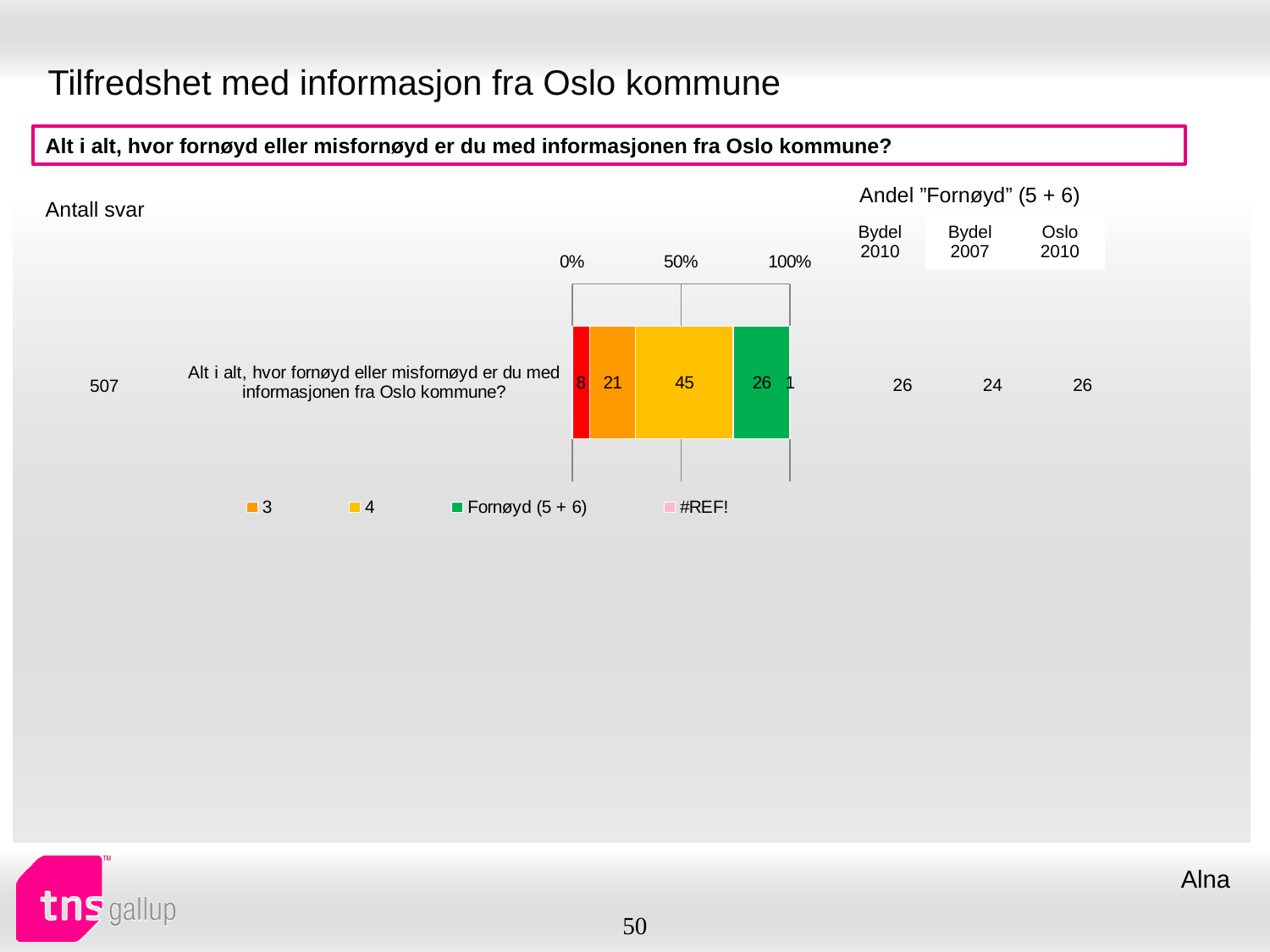
What is the "Antall svar" (number of responses) shown for the question? 507 What is the value of the "3" segment in the stacked bar? 21 Which legend category has the largest segment in the stacked bar? 4 What kind of chart is shown on the slide? bar chart What is the difference between the "4" segment and the "Fornøyd (5 + 6)" segment? 19 What is the value of the "Fornøyd (5 + 6)" segment in the stacked bar? 26 What is the value of the "4" segment in the stacked bar? 45 How many bars does the chart contain? 1 What is the value of the red segment at the left end of the stacked bar? 8 Which is larger, the "3" segment or the "Fornøyd (5 + 6)" segment? Fornøyd (5 + 6) How many entries does the chart legend list? 4 In the "Andel Fornøyd (5 + 6)" table, what is the value for Bydel 2007? 24